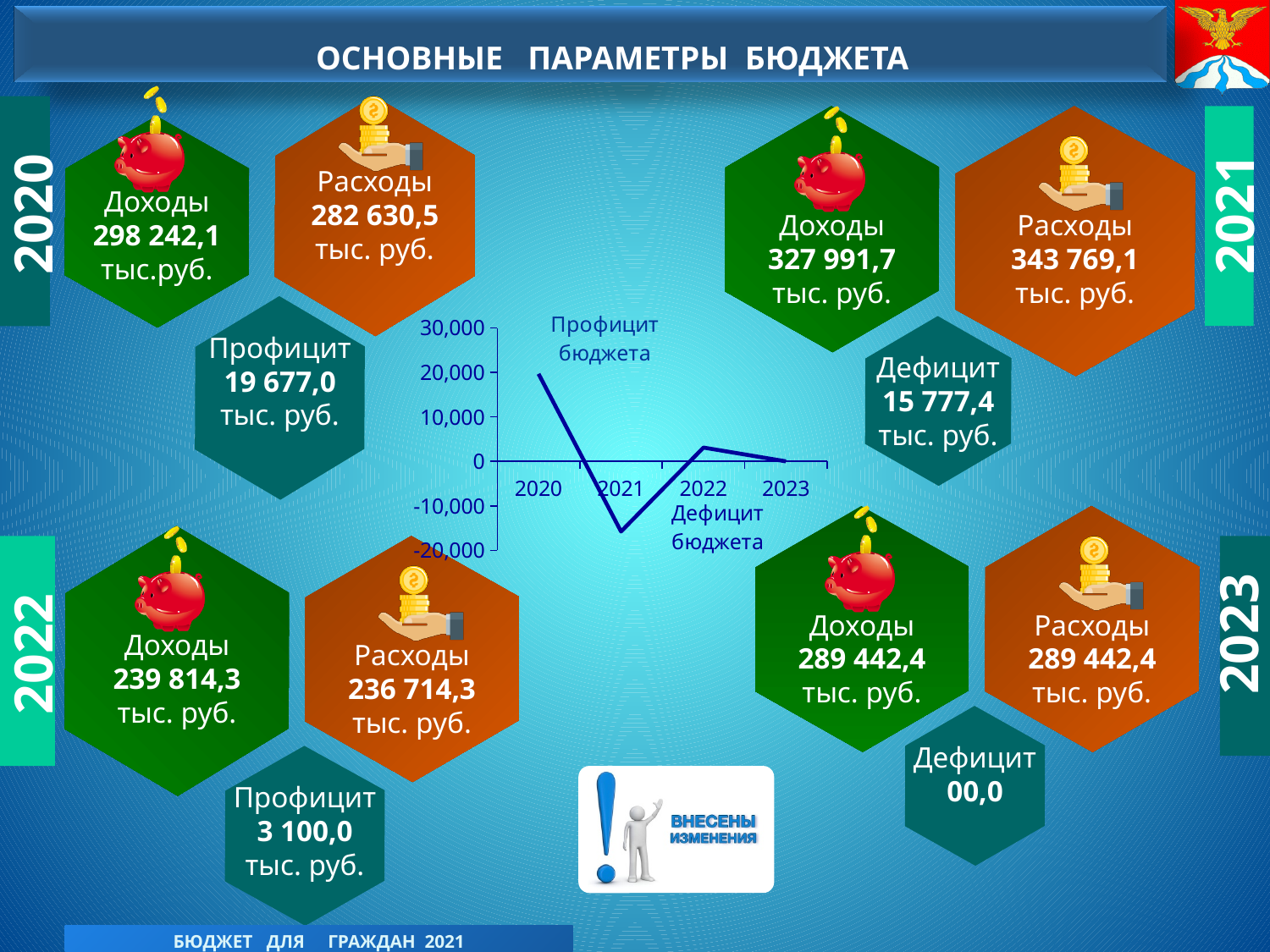
Which year has the highest value on the line chart? 2020 What is the highest tick value shown on the y axis of the line chart? 30,000 What kind of chart is shown in the centre of the slide? line chart Is the value for 2022 on the line chart greater or less than 0? greater How many years are plotted on the x axis of the line chart? 4 Is the value for 2022 on the line chart greater or less than 10,000? less On the line chart, which is larger: the value for 2020 or the value for 2022? 2020 Which year has the lowest value on the line chart? 2021 What label is written near the bottom of the line chart, below the 2022 point? Дефицит бюджета Is the value for 2020 on the line chart greater or less than 10,000? greater Does the line chart rise or fall from 2020 to 2021? fall